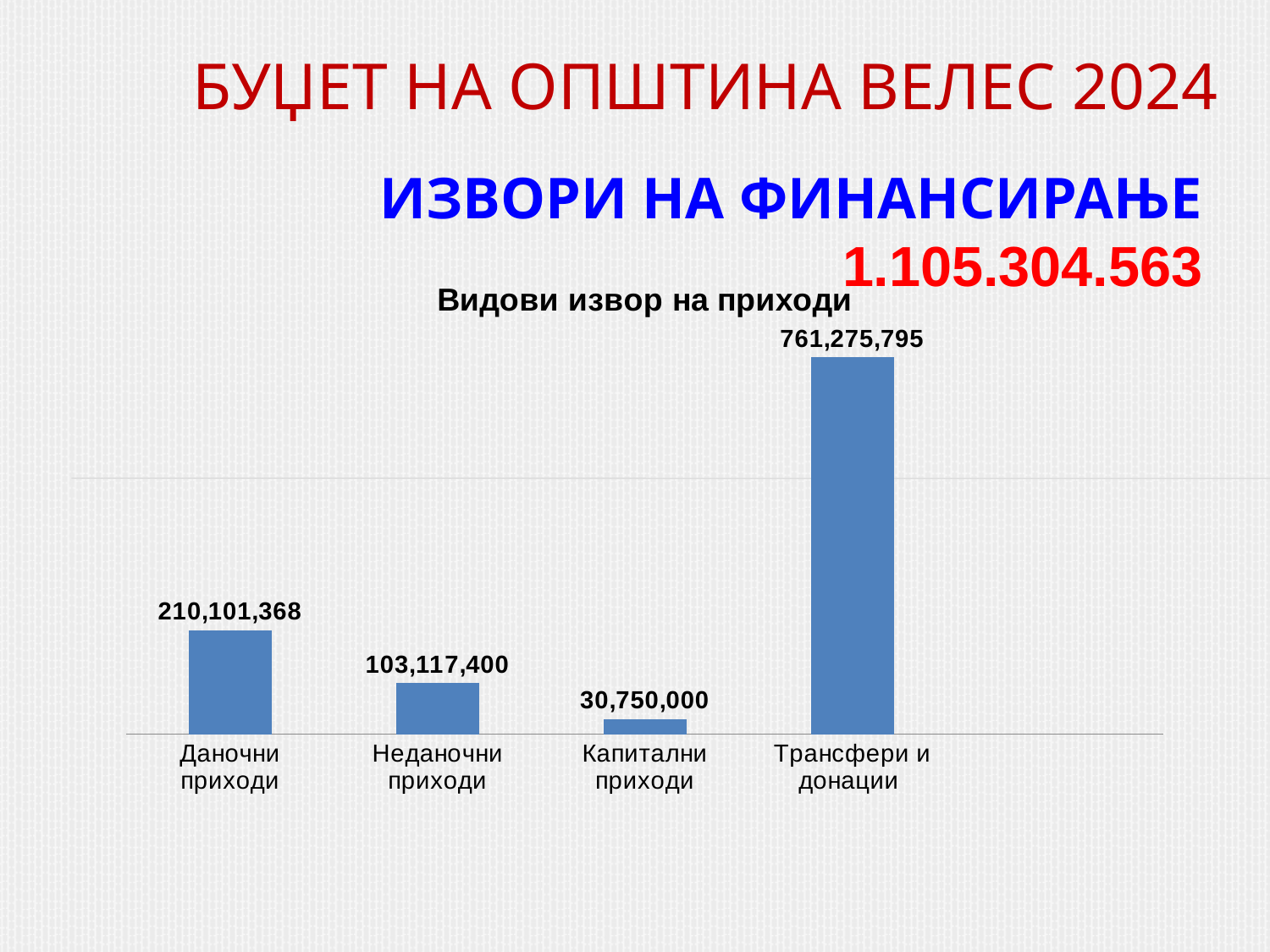
What is the difference between Даночни приходи and Неданочни приходи? 106,983,968 What is the value for Капитални приходи? 30,750,000 How many categories are shown in the chart? 4 Which category has the lowest value? Капитални приходи What is the value for Неданочни приходи? 103,117,400 What kind of chart is shown on the slide? Bar chart What is the value for Даночни приходи? 210,101,368 What is the value for Трансфери и донации? 761,275,795 What is the difference between Трансфери и донации and Даночни приходи? 551,174,427 Which is larger, Неданочни приходи or Капитални приходи? Неданочни приходи What is the title of the chart? Видови извор на приходи Which category has the highest value? Трансфери и донации